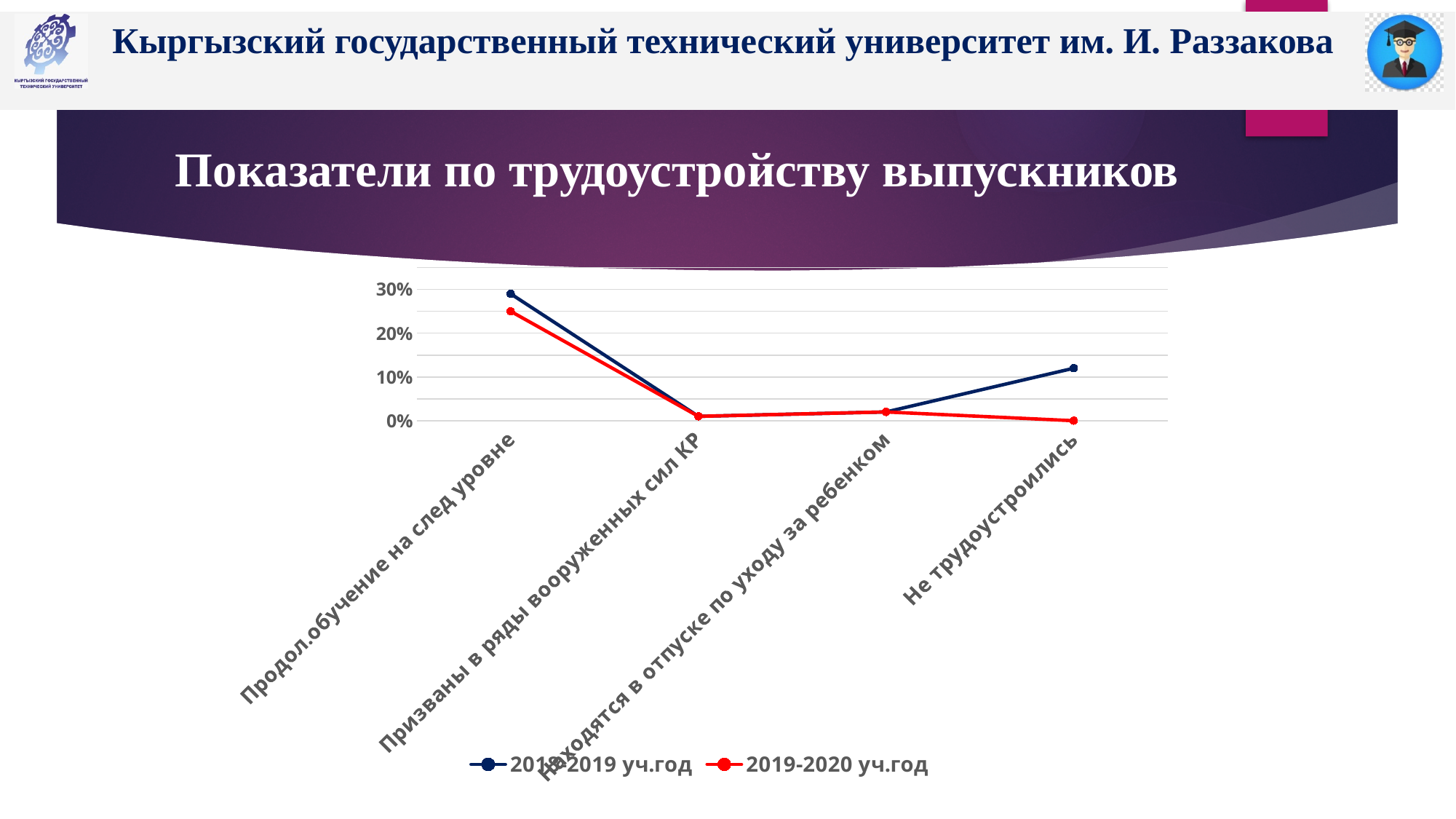
Which category has the highest value for the 2019-2020 уч.год series? Продол.обучение на след уровне Which category has the highest value for the 2018-2019 уч.год series? Продол.обучение на след уровне How many categories are plotted along the x axis? 4 Which category has the lowest value for the 2019-2020 уч.год series? Не трудоустроились What kind of chart is shown on the slide? line chart Is the value for Призваны в ряды вооруженных сил КР in the 2019-2020 уч.год series greater or less than 10%? less Is the value for Продол.обучение на след уровне in the 2018-2019 уч.год series greater or less than 20%? greater Does the 2019-2020 уч.год line rise or fall from Продол.обучение на след уровне to Призваны в ряды вооруженных сил КР? fall Is the value for Не трудоустроились in the 2018-2019 уч.год series greater or less than 10%? greater What colour is the line for the 2019-2020 уч.год series? red How many series does the legend list? 2 For Не трудоустроились, which series has the larger value: 2018-2019 уч.год or 2019-2020 уч.год? 2018-2019 уч.год